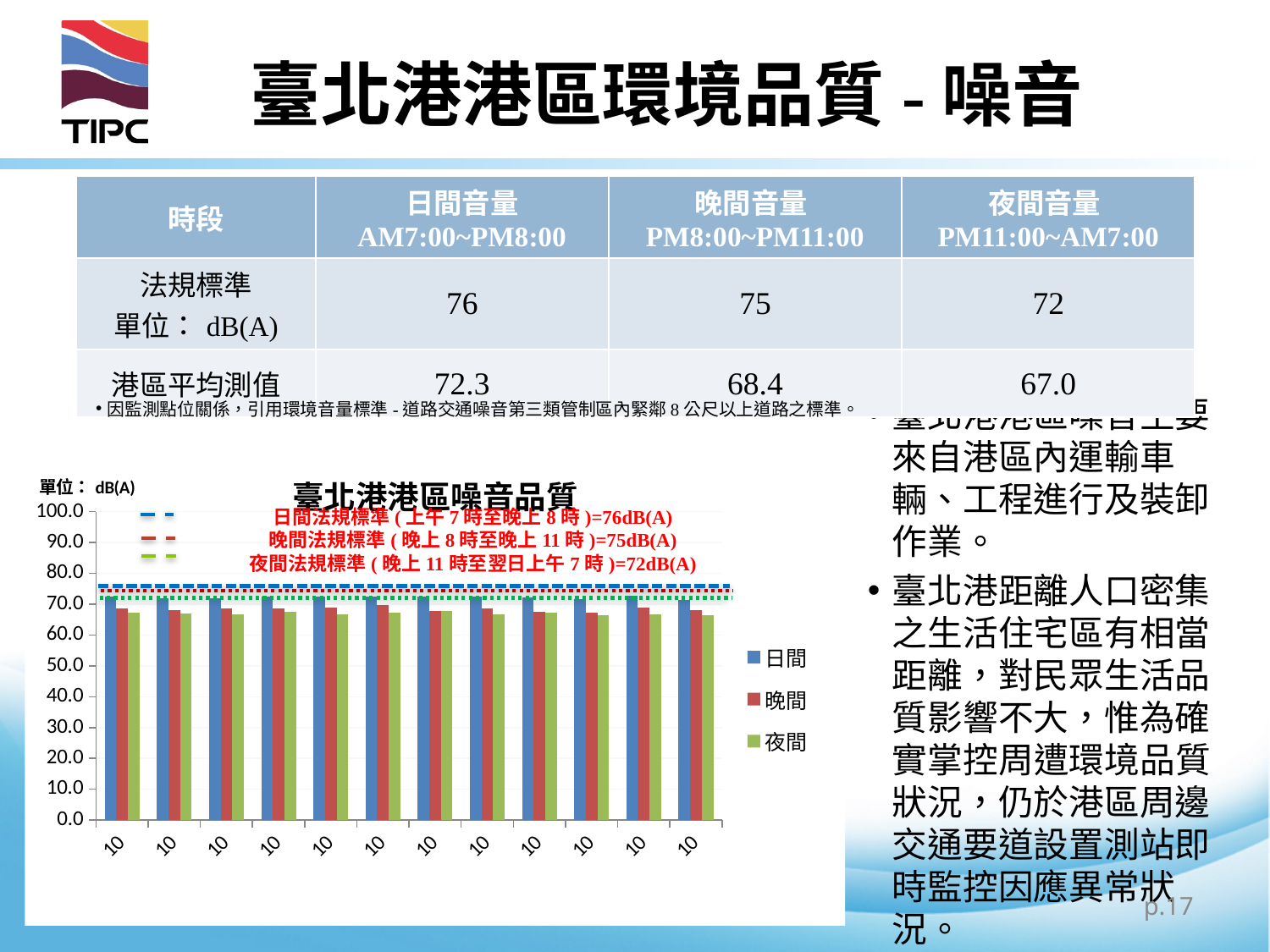
In the leftmost group of bars, which is larger, the 日間 value or the 夜間 value? 日間 How many series does the chart legend list? 3 How many groups of bars are plotted along the x axis of the chart? 12 In the leftmost group of bars, is the value for 日間 greater or less than 80? less In the leftmost group of bars, is the value for 夜間 greater or less than 70? less In the leftmost group of bars, is the value for 日間 greater or less than 60? greater What kind of chart is shown on the slide? bar chart Do the 日間 values rise, fall, or stay roughly flat across the x axis? stay roughly flat What is the title of the chart? 臺北港港區噪音品質 What are the three series named in the chart legend? 日間, 晚間, 夜間